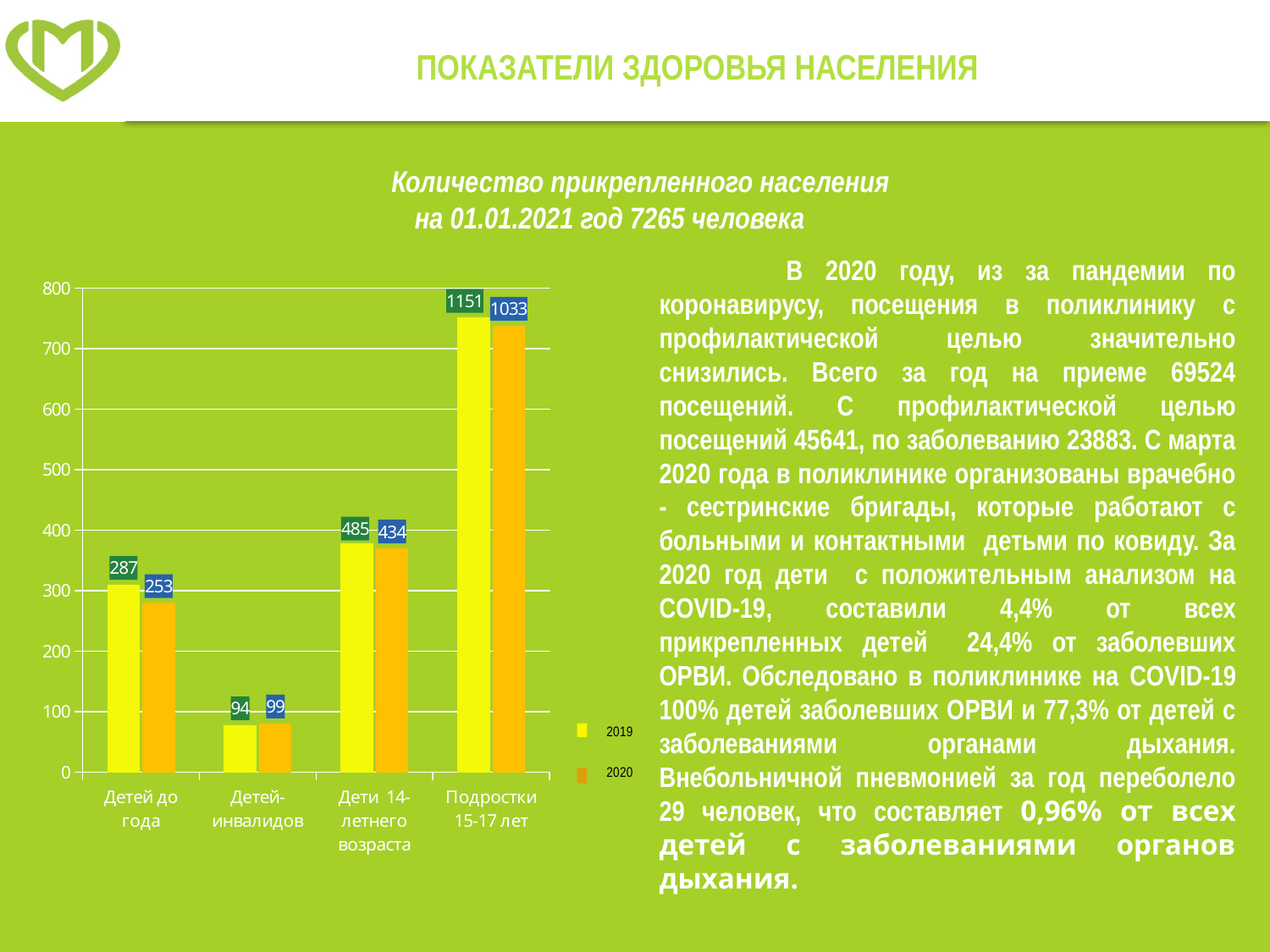
Which category has the highest 2019 value? Подростки 15-17 лет What is the 2020 value for "Подростки 15-17 лет"? 1033 What is the 2020 value for "Дети 14-летнего возраста"? 434 What is the 2019 value for "Детей-инвалидов"? 94 Which category has the lowest 2020 value? Детей-инвалидов How many series does the legend list? 2 What is the difference between the 2019 and 2020 values for "Детей до года"? 34 What kind of chart is shown on the slide? Bar chart Which series is shown in yellow according to the legend? 2019 How many categories are shown on the x axis? 4 For "Детей-инвалидов", which year has the larger value, 2019 or 2020? 2020 What is the 2019 value for "Детей до года"? 287